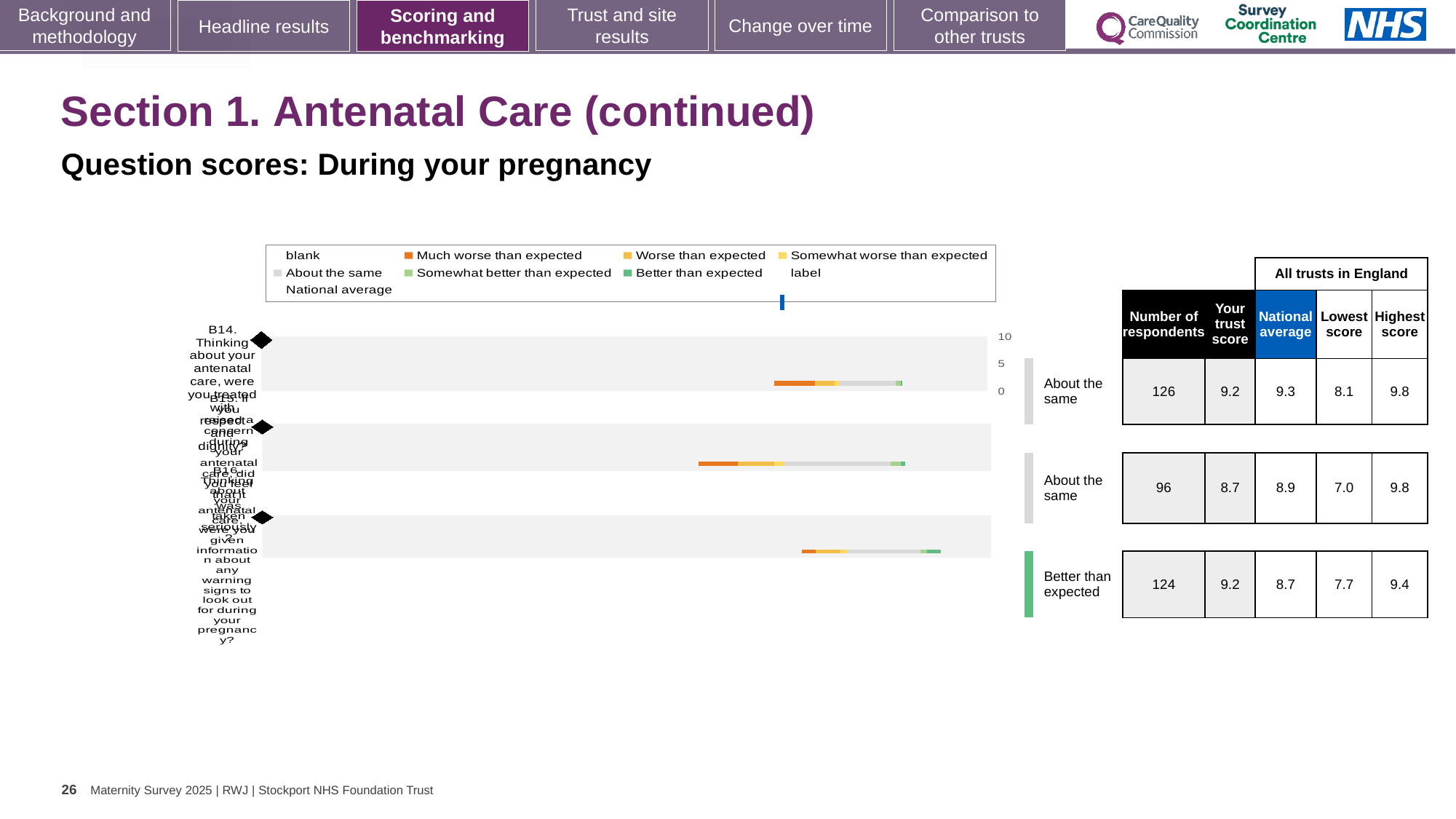
What is the national average for the third (bottom) question? 8.7 How many questions (bars) are plotted in the chart? 3 What benchmark category is shown for the third (bottom) question? Better than expected In the table beside the chart, what is the number of respondents for the first (top) question, B14? 126 What kind of chart is shown on the slide? Bar chart What is the trust score for the first (top) question, B14? 9.2 What is the highest score for the third (bottom) question? 9.4 What colour does the legend use for 'Much worse than expected'? Orange For the second (middle) question, what is the difference between the highest score and the lowest score? 2.8 For the second (middle) question, which is larger: the trust score or the national average? National average Which question has the highest number of respondents? The first (top) question, B14 Which question has the lowest 'Lowest score' value? The second (middle) question